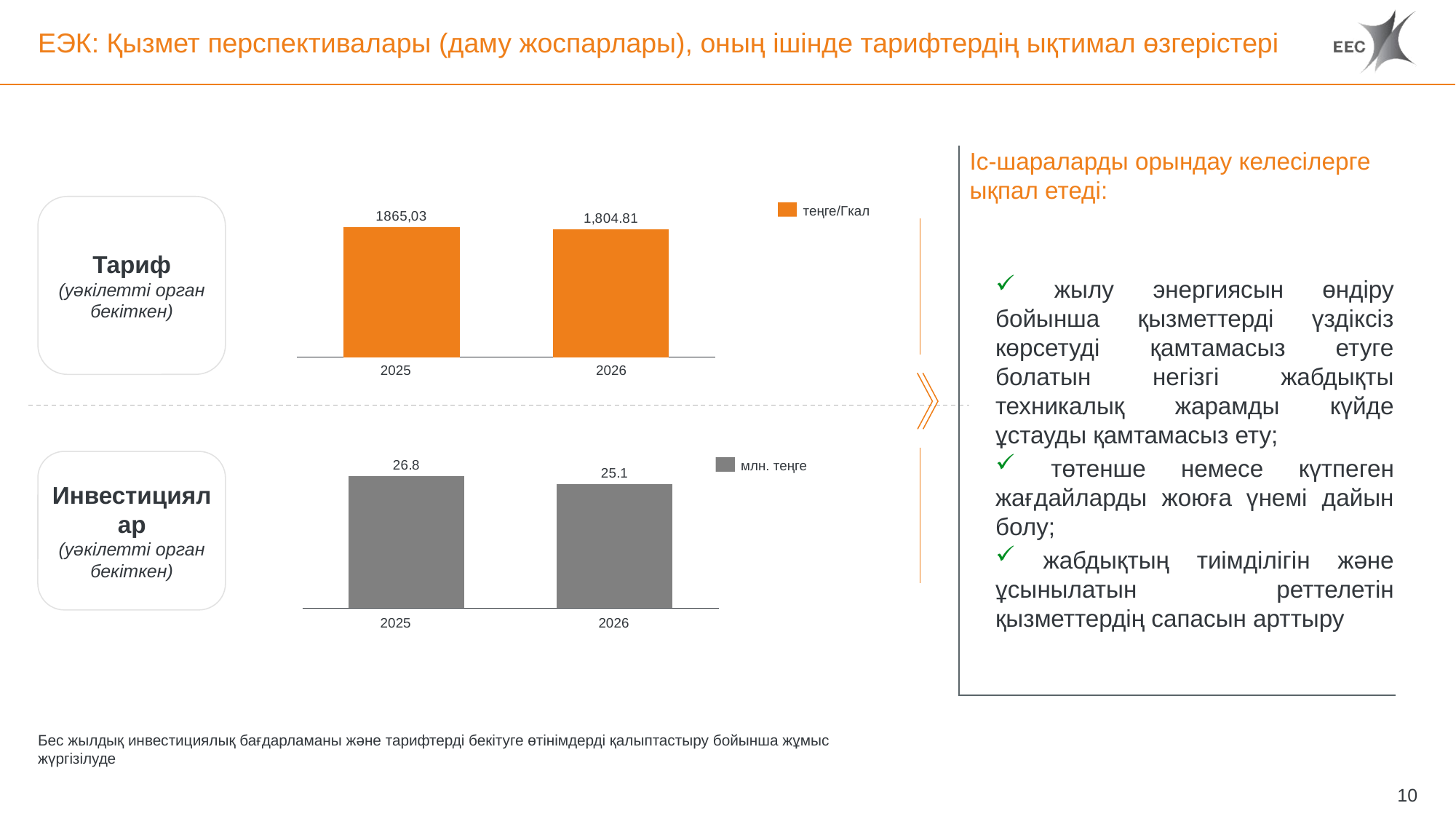
What unit does the legend of the top chart (Тариф) show? теңге/Гкал In the bottom chart (Инвестициялар), what is the value for 2026? 25.1 In the bottom chart (Инвестициялар), which year has the higher value? 2025 In the bottom chart (Инвестициялар), do the values rise or fall from 2025 to 2026? fall What type of chart is the top chart (Тариф)? bar chart In the top chart (Тариф), what is the value for 2026? 1,804.81 In the top chart (Тариф), which year has the lower value? 2026 In the bottom chart (Инвестициялар), what is the difference between the 2025 and 2026 values? 1.7 In the bottom chart (Инвестициялар), what is the value for 2025? 26.8 In the top chart (Тариф), is the value for 2025 larger or smaller than the value for 2026? larger How many bars are shown in the bottom chart (Инвестициялар)? 2 In the top chart (Тариф), what is the value for 2025? 1865,03